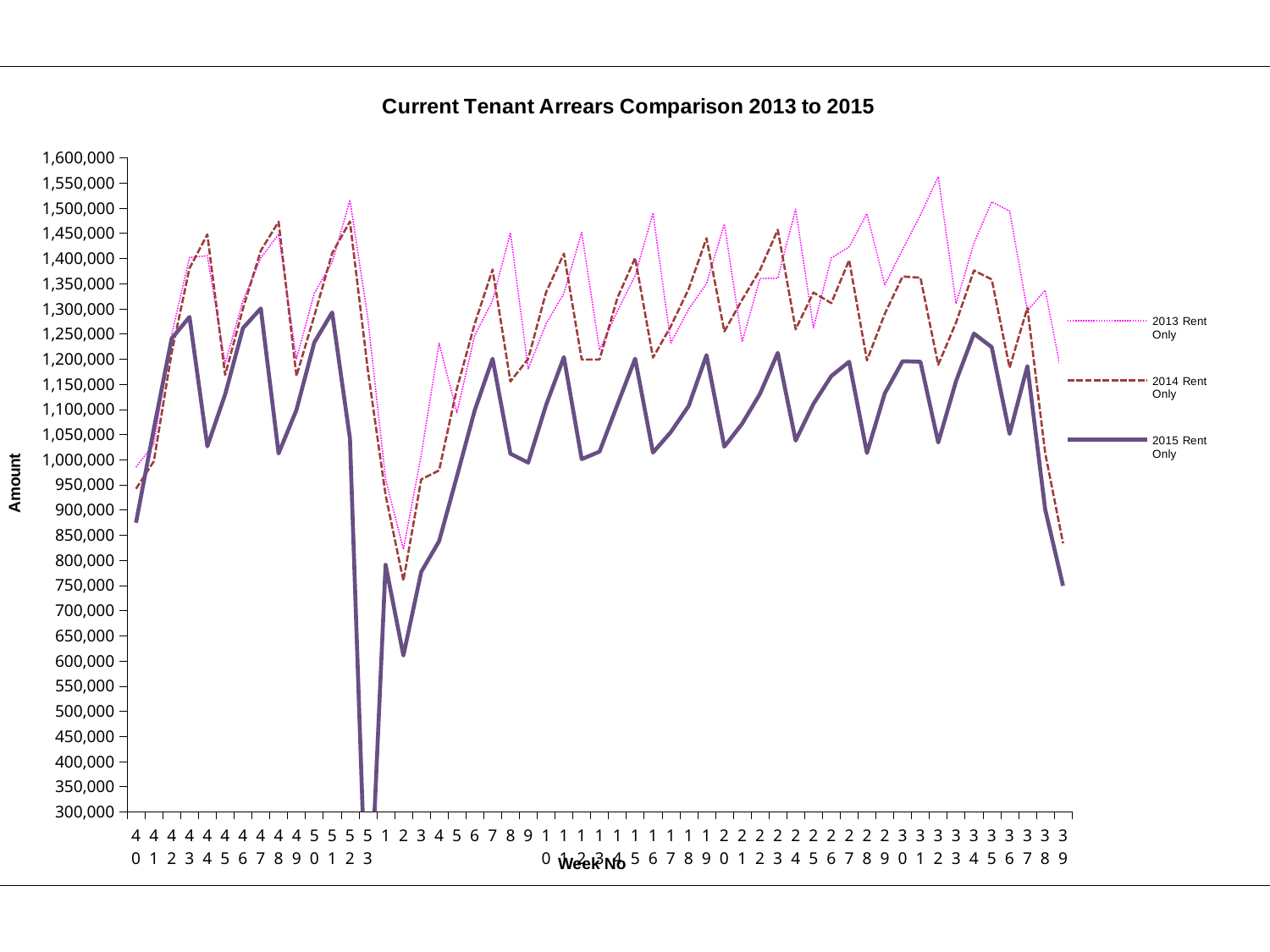
What is the title of the chart? Current Tenant Arrears Comparison 2013 to 2015 How many series does the legend list? 3 What is the label on the vertical axis of the chart? Amount At week 32, which is larger: the value for 2014 Rent Only or the value for 2015 Rent Only? 2014 Rent Only Is the value for 2015 Rent Only at week 2 greater or less than 700,000? less What kind of chart is shown on the slide? Line chart Do the values for 2015 Rent Only rise or fall from week 40 to week 43? rise Which series reaches the highest value anywhere on the chart? 2013 Rent Only Is the value for 2014 Rent Only at week 39 greater or less than 900,000? less At week 2, which is larger: the value for 2013 Rent Only or the value for 2015 Rent Only? 2013 Rent Only Is the value for 2013 Rent Only at week 32 greater or less than 1,500,000? greater Which series drops to the lowest value anywhere on the chart? 2015 Rent Only